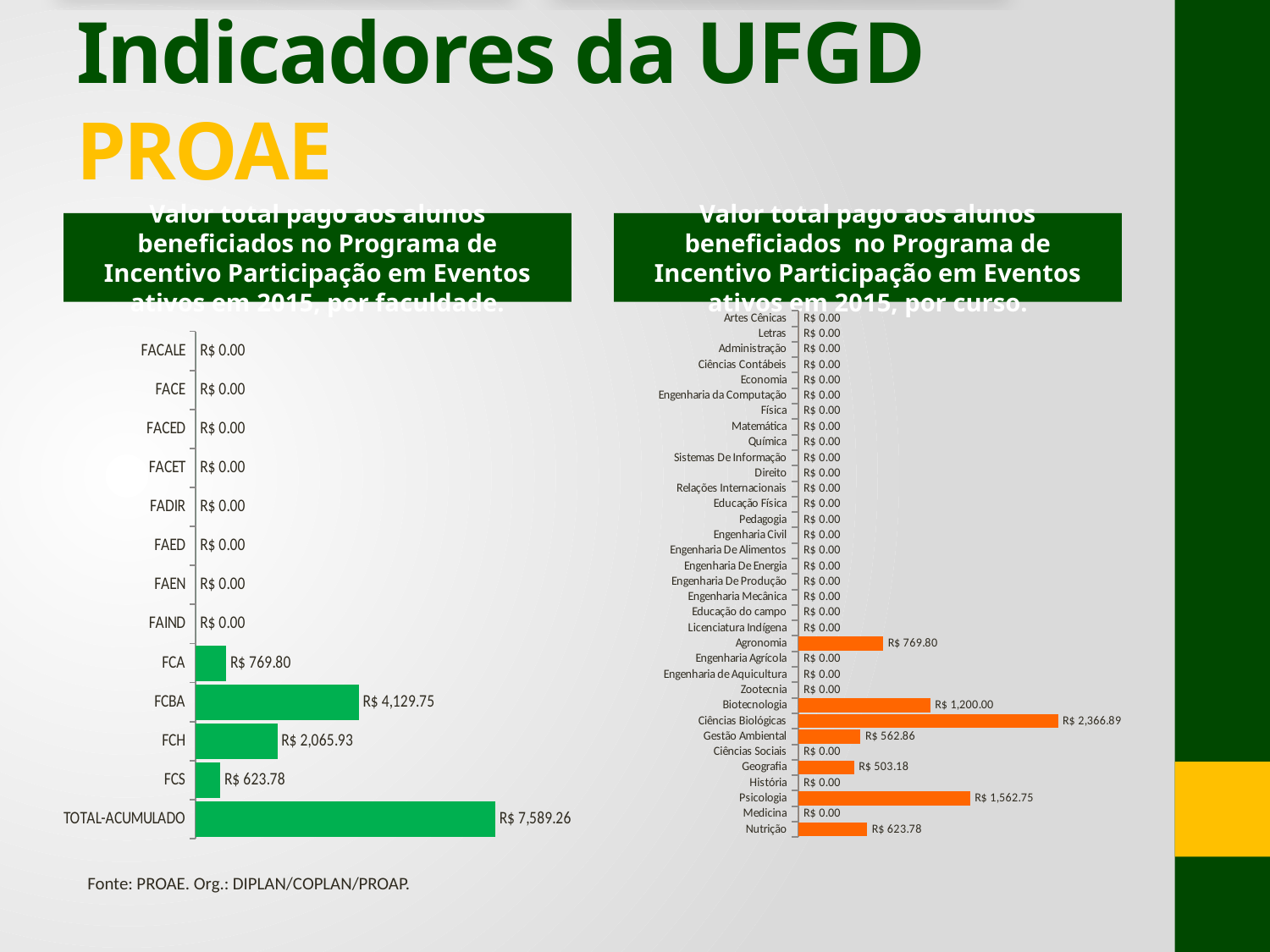
In the left chart (por faculdade), which faculty (excluding the accumulated total) has the highest value? FCBA In the right chart (por curso), what is the value for Psicologia? R$ 1,562.75 In the right chart (por curso), which is larger, the value for Biotecnologia or the value for Gestão Ambiental? Biotecnologia In the right chart (por curso), what is the value for Ciências Biológicas? R$ 2,366.89 In the left chart (por faculdade), what is the value for TOTAL-ACUMULADO? R$ 7,589.26 In the left chart (por faculdade), which is larger, the value for FCA or the value for FCS? FCA In the right chart (por curso), which course has the highest value? Ciências Biológicas In the left chart (por faculdade), what is the value for FCBA? R$ 4,129.75 What type of chart is the left chart (por faculdade)? Bar chart In the right chart (por curso), what is the difference between the values for Ciências Biológicas and Psicologia? R$ 804.14 In the left chart (por faculdade), how many categories are shown? 13 In the left chart (por faculdade), what is the difference between the values for FCBA and FCH? R$ 2,063.82